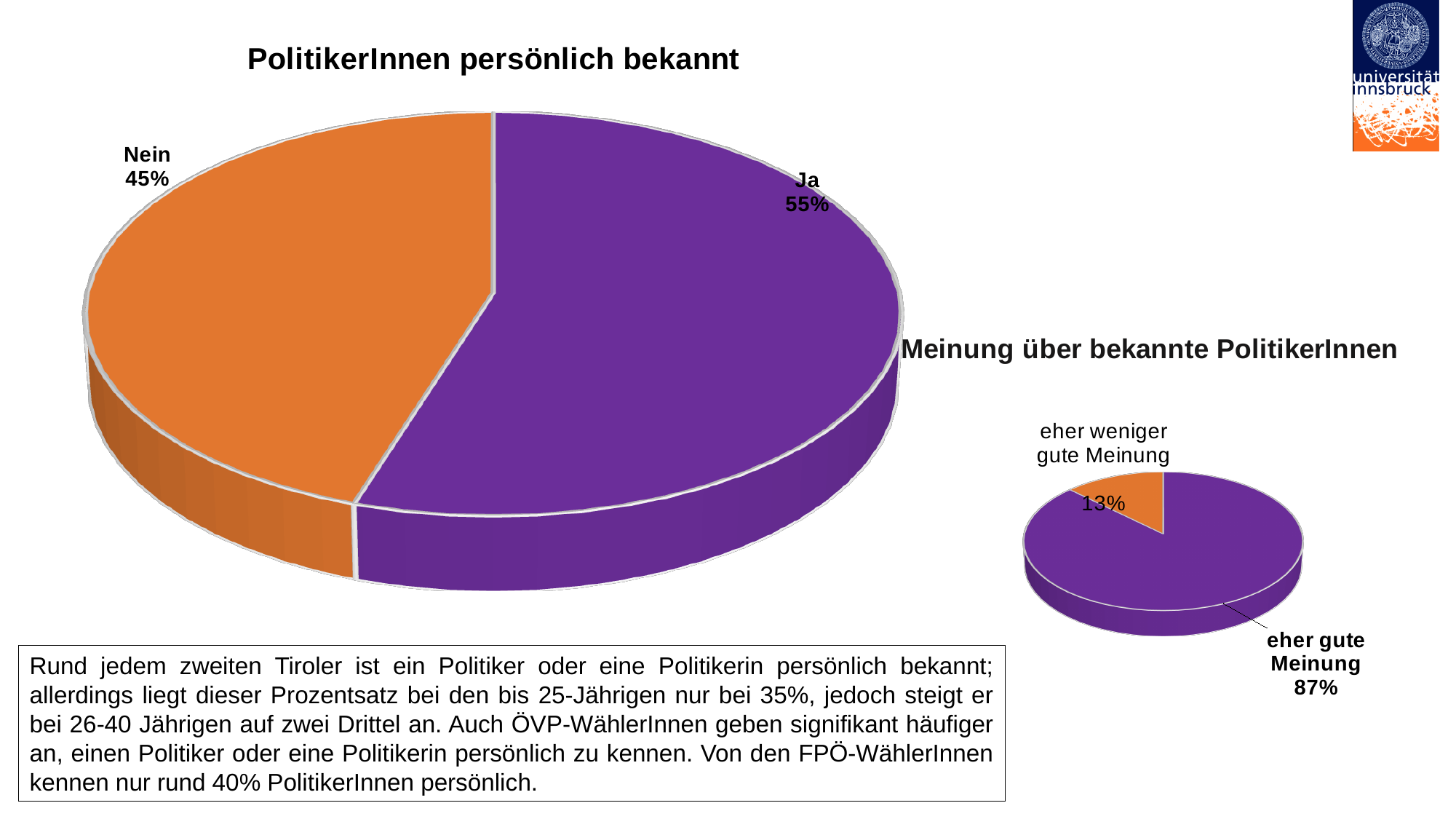
In the chart titled "Meinung über bekannte PolitikerInnen", what is the value for "eher weniger gute Meinung"? 13% Which is larger: the "Nein" slice in the chart titled "PolitikerInnen persönlich bekannt" or the "eher weniger gute Meinung" slice in the chart titled "Meinung über bekannte PolitikerInnen"? Nein In the chart titled "PolitikerInnen persönlich bekannt", which slice is the largest? Ja In the chart titled "PolitikerInnen persönlich bekannt", what is the difference between the "Ja" and "Nein" slices? 10% In the chart titled "PolitikerInnen persönlich bekannt", how many slices does the pie have? 2 In the chart titled "PolitikerInnen persönlich bekannt", what is the value for "Ja"? 55% What kind of chart is the chart titled "PolitikerInnen persönlich bekannt"? Pie chart In the chart titled "PolitikerInnen persönlich bekannt", what is the value for "Nein"? 45% In the chart titled "Meinung über bekannte PolitikerInnen", what colour is the "eher gute Meinung" slice? Purple In the chart titled "Meinung über bekannte PolitikerInnen", what is the difference between the "eher gute Meinung" and "eher weniger gute Meinung" slices? 74% In the chart titled "Meinung über bekannte PolitikerInnen", which slice is the smallest? eher weniger gute Meinung In the chart titled "Meinung über bekannte PolitikerInnen", what is the value for "eher gute Meinung"? 87%